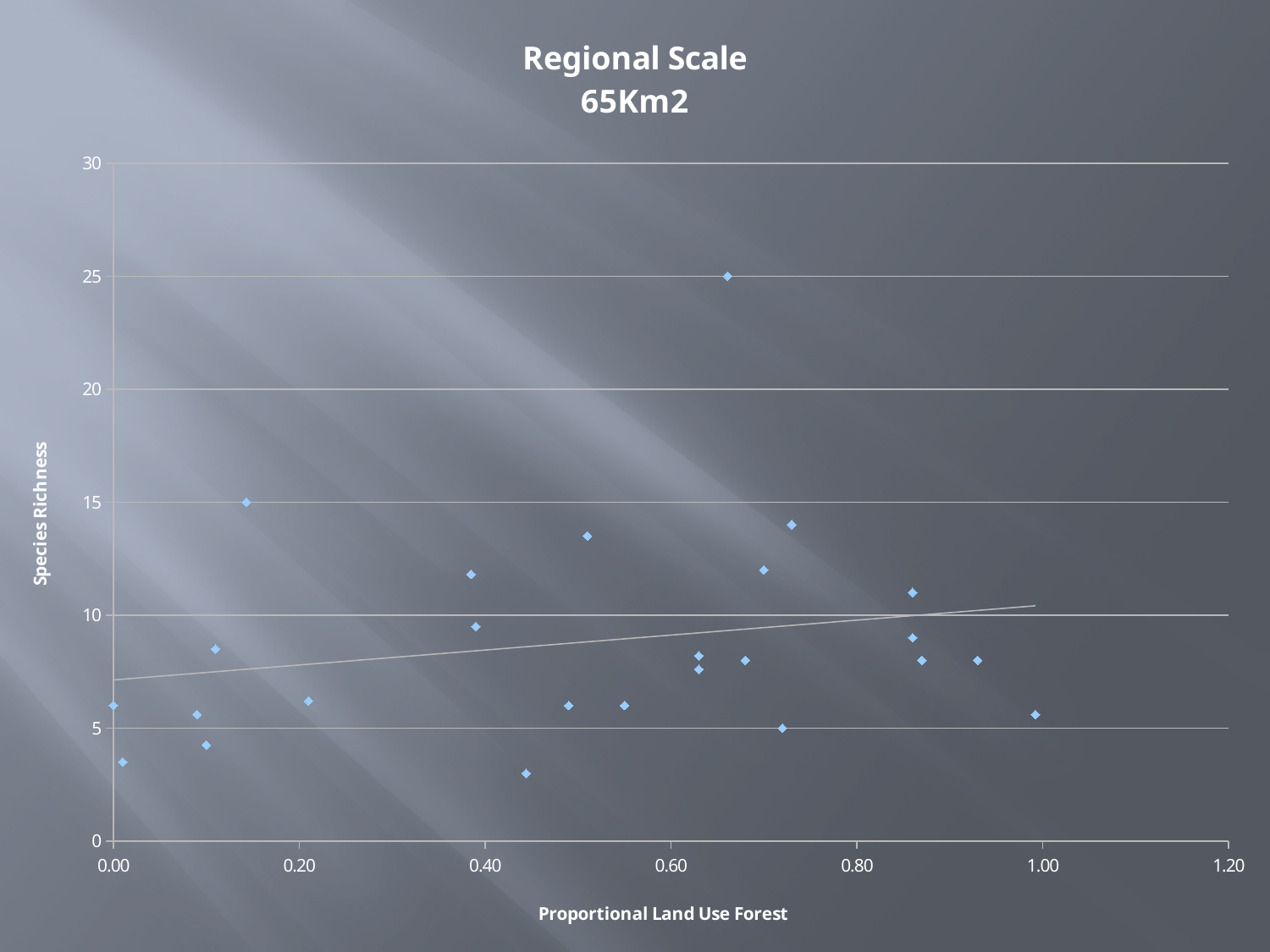
What is the label of the horizontal axis? Proportional Land Use Forest Is the highest plotted Species Richness value greater or less than 20? greater What kind of chart is shown on the slide? scatter chart Does the trendline rise or fall as Proportional Land Use Forest increases? rises Is the Species Richness value of the point at Proportional Land Use Forest 0.00 greater or less than 10? less What is the highest Species Richness value plotted on the chart? 25 Is the lowest plotted Species Richness value greater or less than 5? less What is the title of the chart? Regional Scale 65Km2 Which is larger: the Species Richness of the point near 0.66 on the x axis or the point near 0.14 on the x axis? the point near 0.66